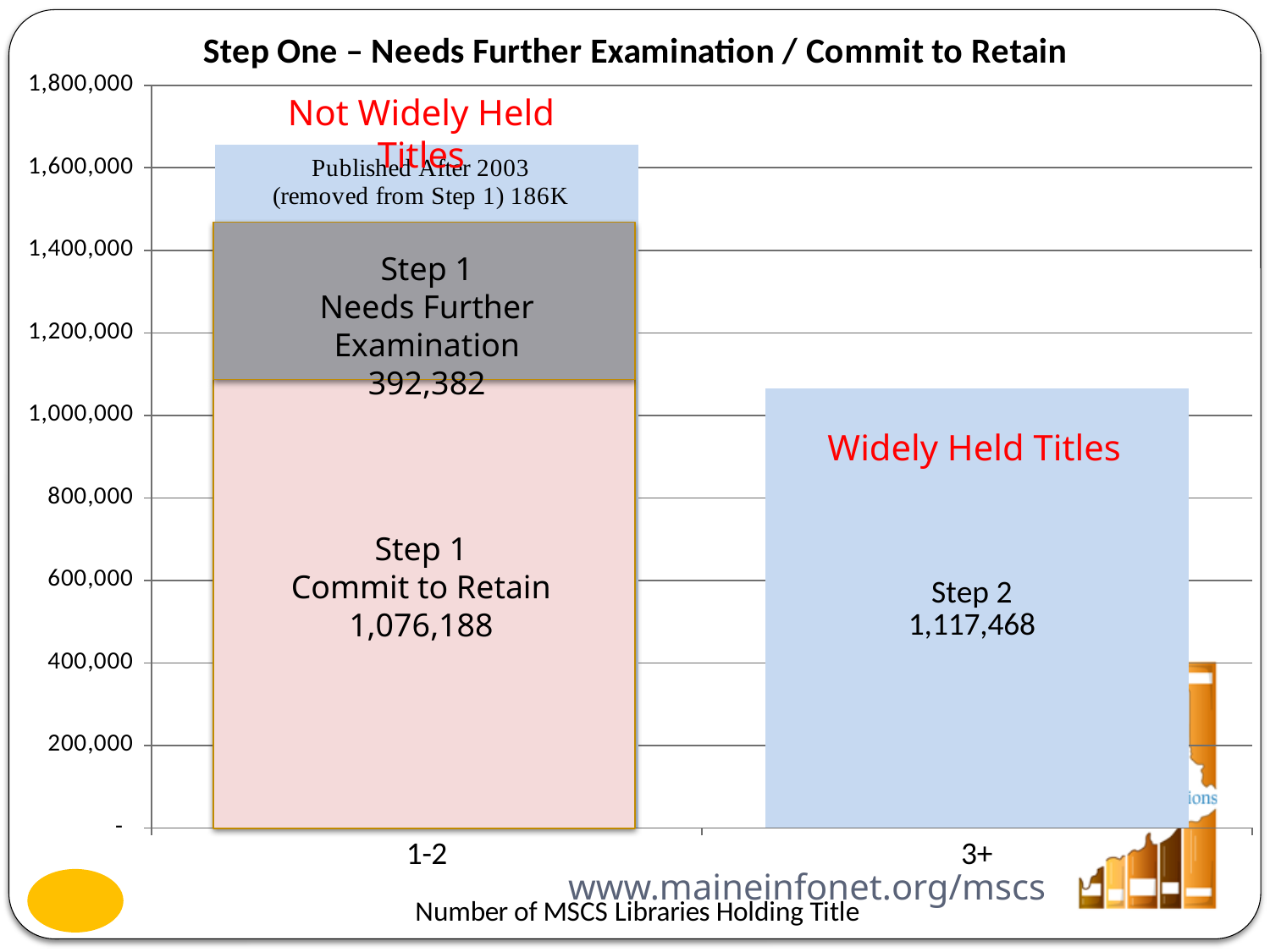
How many titles were published after 2003 and removed from Step 1, according to the label on the 1-2 bar? 186K Which is larger: the Step 2 value for 3+ or the Step 1 Commit to Retain value for 1-2? Step 2 value for 3+ What kind of chart is shown on the slide? Bar chart What is the value of the Step 1 Commit to Retain segment for the 1-2 category? 1,076,188 What is the value of the Step 2 bar for the 3+ category? 1,117,468 What is the difference between the Step 2 value (3+) and the Step 1 Commit to Retain value (1-2)? 41,280 What is the value of the Step 1 Needs Further Examination segment for the 1-2 category? 392,382 Is the top of the full stacked bar for the 1-2 category greater or less than 1,600,000? greater What is the title of the x axis? Number of MSCS Libraries Holding Title What is the difference between the Step 1 Commit to Retain value and the Step 1 Needs Further Examination value? 683,806 What is the combined total of the Step 1 Commit to Retain and Step 1 Needs Further Examination segments? 1,468,570 How many categories are shown on the x axis? 2